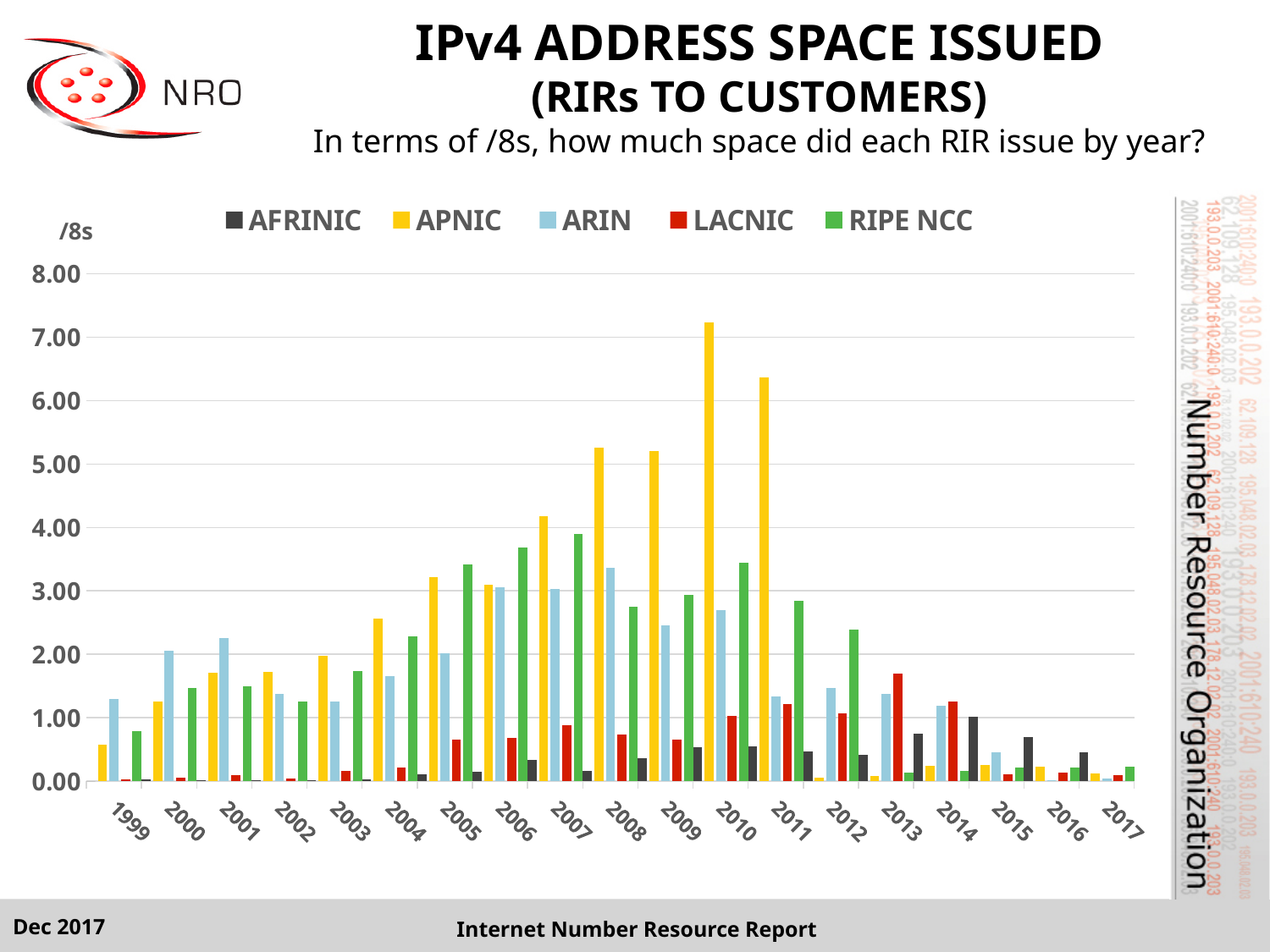
Which RIR has the tallest bar in 2013? LACNIC In which year is the APNIC bar the highest? 2010 Is the APNIC value for 2011 greater or less than 6.00? greater What unit is shown on the y axis? /8s Is the APNIC value for 2010 greater or less than 7.00? greater Is the ARIN value for 2008 greater or less than 3.00? greater Which RIR has the tallest bar in 2010? APNIC Which is larger in 2007, the RIPE NCC value or the ARIN value? RIPE NCC Which is larger, the APNIC value for 2010 or the APNIC value for 2011? APNIC 2010 What kind of chart is shown on the slide? bar chart How many years are shown along the x axis? 19 How many series does the legend list? 5